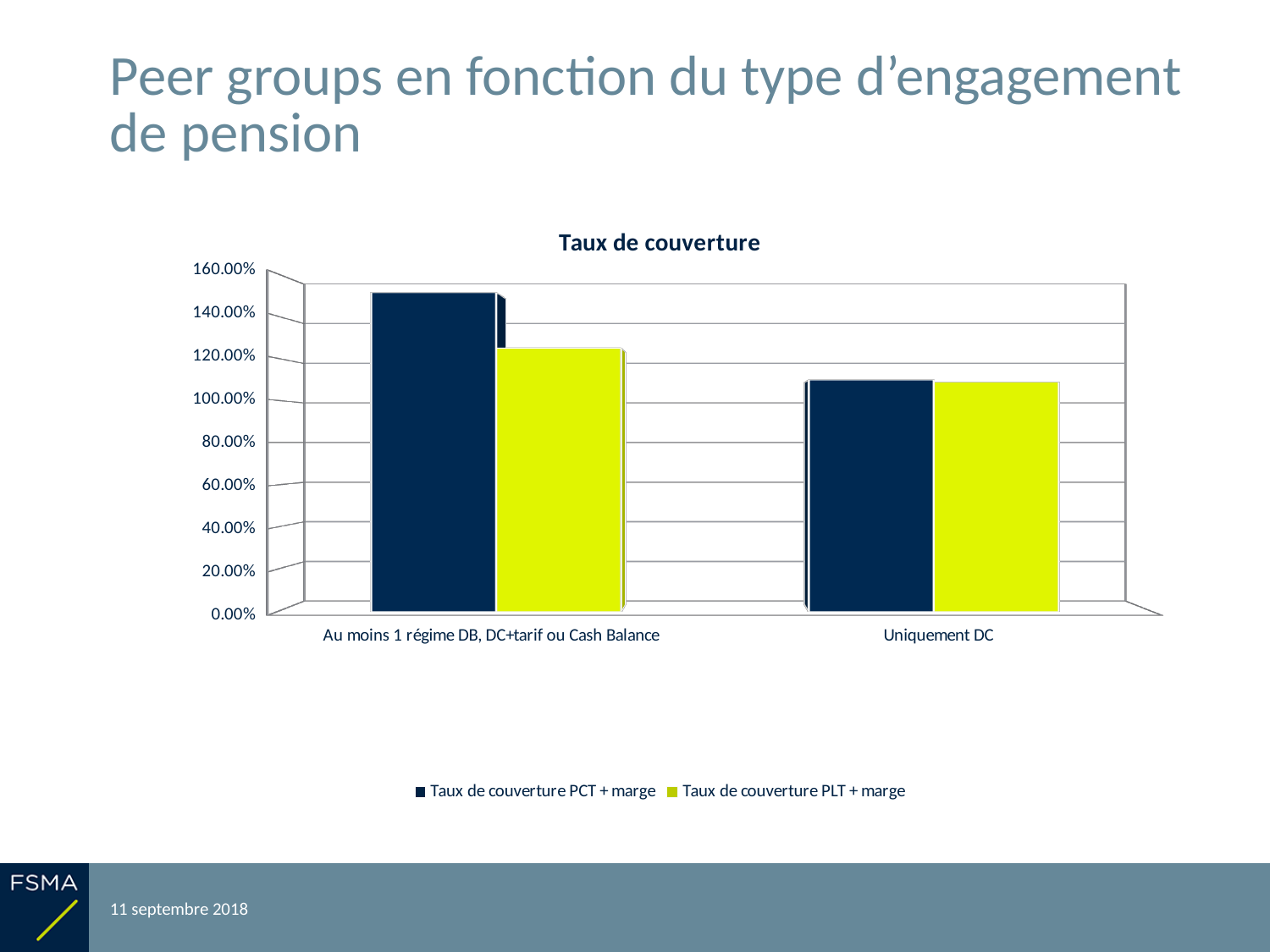
Is the value of Taux de couverture PLT + marge for 'Au moins 1 régime DB, DC+tarif ou Cash Balance' greater or less than 140.00%? less Which series is shown in yellow-green? Taux de couverture PLT + marge For the series Taux de couverture PCT + marge, which category has the higher value? Au moins 1 régime DB, DC+tarif ou Cash Balance For the series Taux de couverture PLT + marge, which category has the lower value? Uniquement DC Is the value of Taux de couverture PCT + marge for 'Uniquement DC' greater or less than 100.00%? greater What is the title of the chart? Taux de couverture Is the value of Taux de couverture PLT + marge for 'Uniquement DC' greater or less than 120.00%? less How many series does the legend list? 2 How many categories are shown on the x axis? 2 For 'Au moins 1 régime DB, DC+tarif ou Cash Balance', which series has the larger value: Taux de couverture PCT + marge or Taux de couverture PLT + marge? Taux de couverture PCT + marge What type of chart is shown on the slide? bar chart